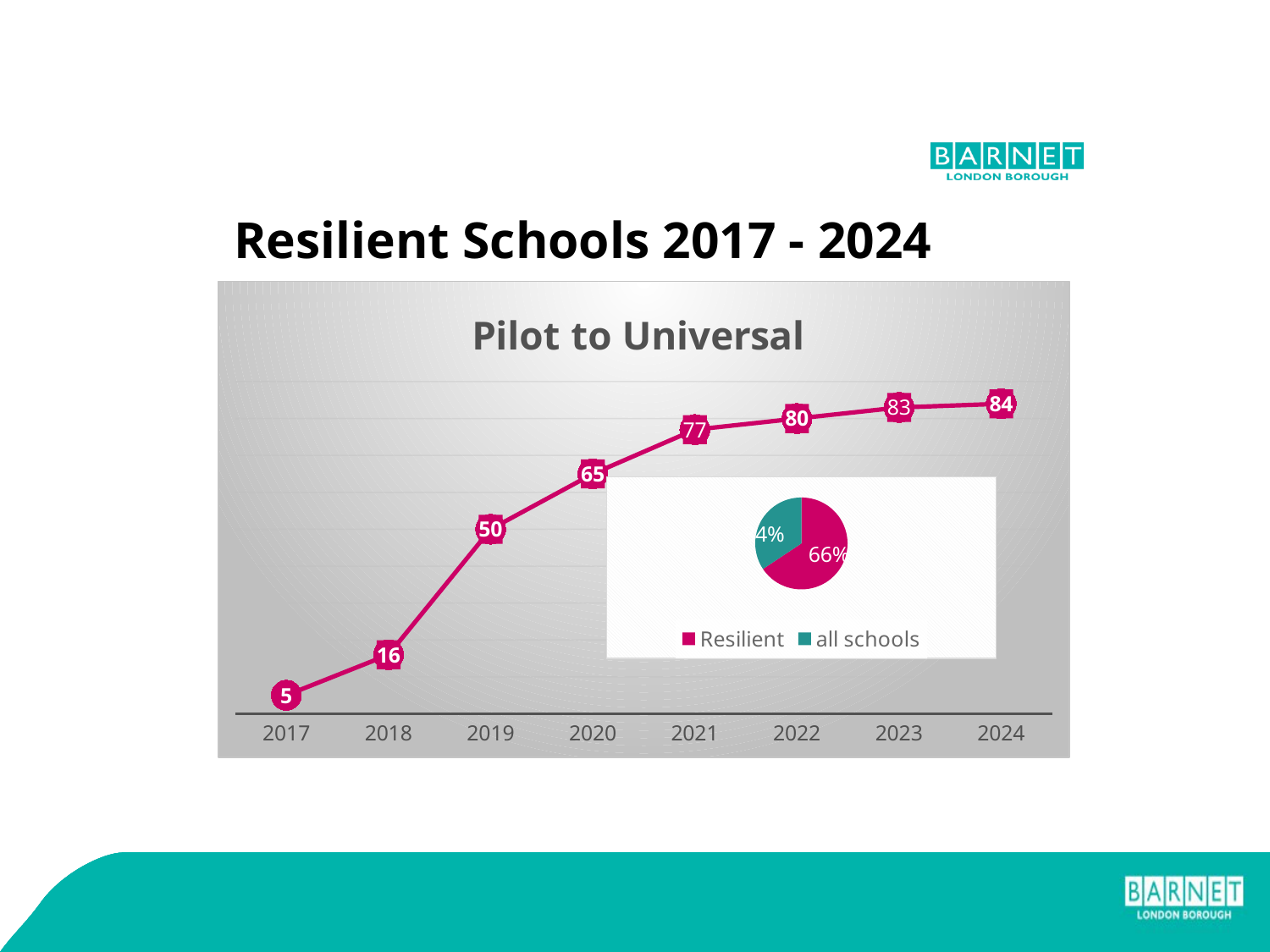
How many years are plotted on the x axis of the 'Pilot to Universal' line chart? 8 In the 'Pilot to Universal' line chart, which is larger, the value for 2020 or the value for 2021? 2021 How many entries does the legend of the pie chart inset list? 2 In the 'Pilot to Universal' line chart, which year has the lowest value? 2017 In the 'Pilot to Universal' line chart, what is the value for 2017? 5 In the 'Pilot to Universal' line chart, what is the difference between the values for 2019 and 2018? 34 In the 'Pilot to Universal' line chart, what is the difference between the values for 2024 and 2017? 79 In the pie chart inset on the slide, what share is labelled for the 'Resilient' slice? 66% In the 'Pilot to Universal' line chart, what is the value for 2022? 80 Do the values in the 'Pilot to Universal' line chart rise or fall from 2017 to 2024? rise In the 'Pilot to Universal' line chart, what is the value for 2019? 50 In the 'Pilot to Universal' line chart, which year has the highest value? 2024